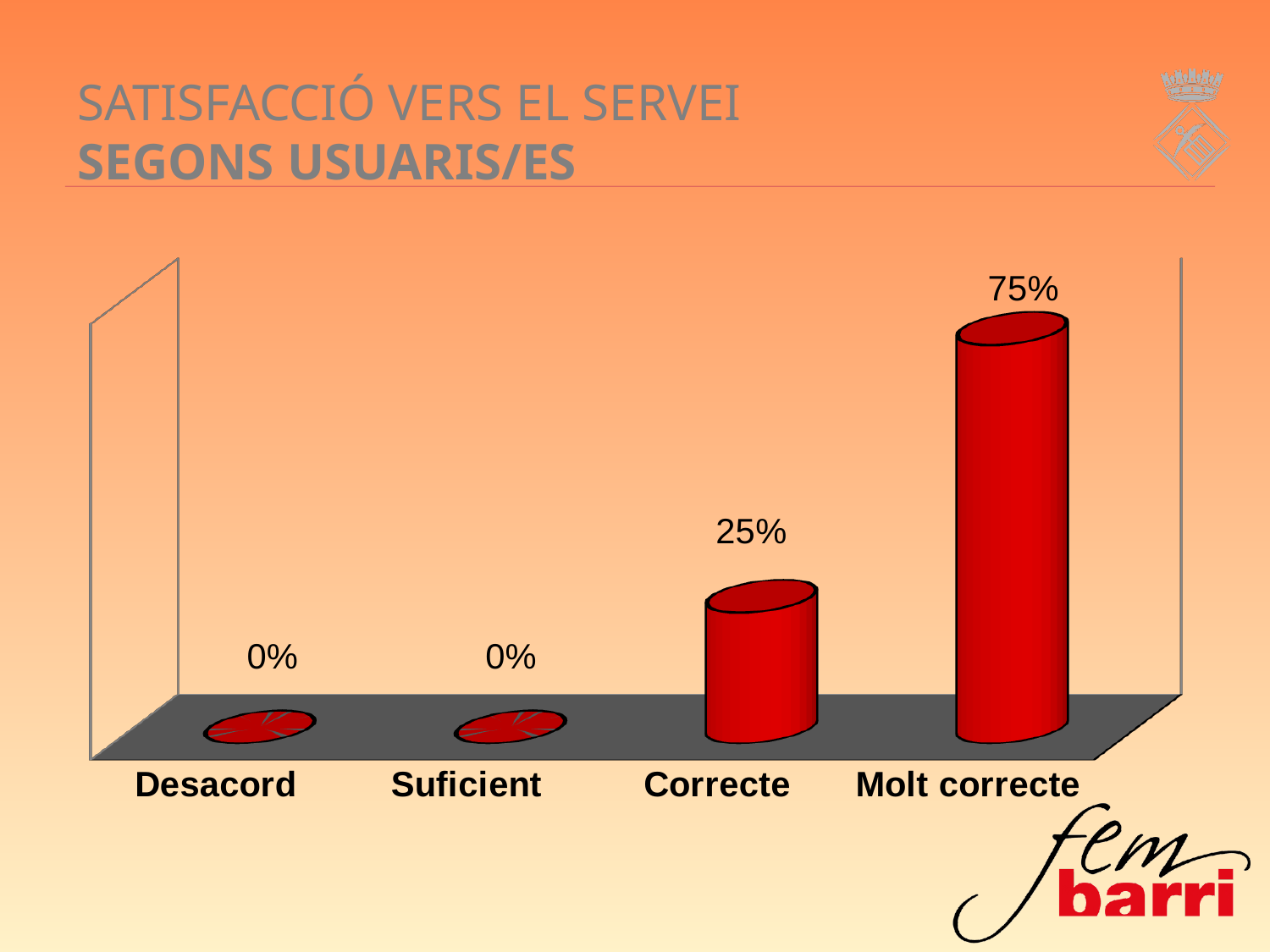
Which is larger, the value for Correcte or the value for Molt correcte? Molt correcte What is the value for Correcte? 25% Do the values rise or fall from left to right along the x axis? Rise What is the total of the values for Correcte and Molt correcte? 100% Which category has the highest value? Molt correcte How many categories are shown on the x axis? 4 What kind of chart is shown on the slide? Bar chart What is the value for Suficient? 0% What is the value for Molt correcte? 75% What colour are the bars in the chart? Red What is the difference between the values for Molt correcte and Correcte? 50% What is the value for Desacord? 0%